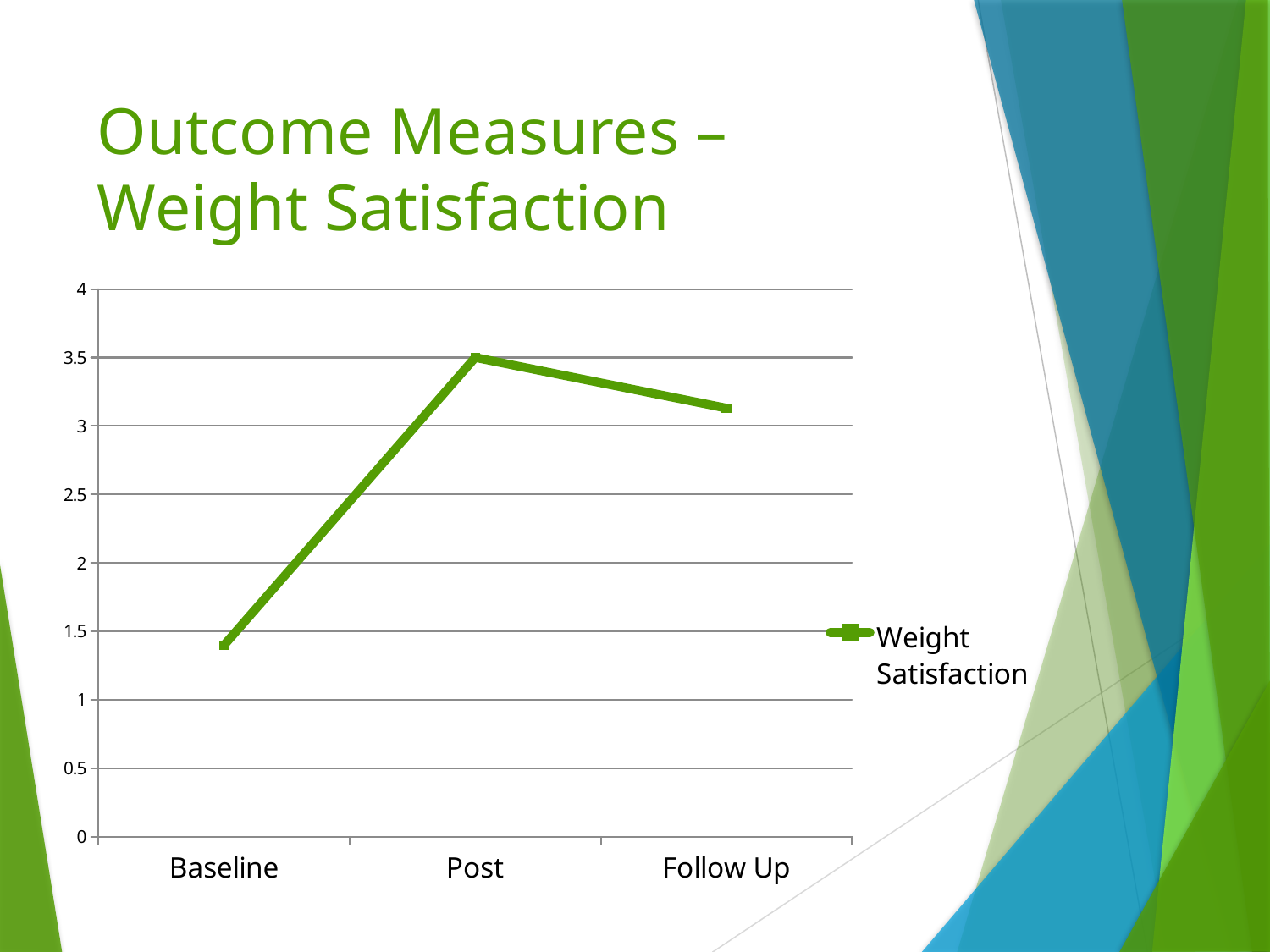
Which is larger, the Weight Satisfaction value at Baseline or at Follow Up? Follow Up How many points are plotted along the x axis? 3 Which time point has the lowest Weight Satisfaction value? Baseline Is the Weight Satisfaction value at Baseline greater or less than 2? less Is the Weight Satisfaction value at Follow Up greater or less than 3? greater Is the Weight Satisfaction value at Baseline greater or less than 1.5? less How many series does the legend list? 1 Which time point has the highest Weight Satisfaction value? Post What kind of chart is shown on the slide? line chart Does the Weight Satisfaction value rise or fall from Baseline to Post? rise What series name is shown in the chart legend? Weight Satisfaction Which is larger, the Weight Satisfaction value at Post or at Follow Up? Post